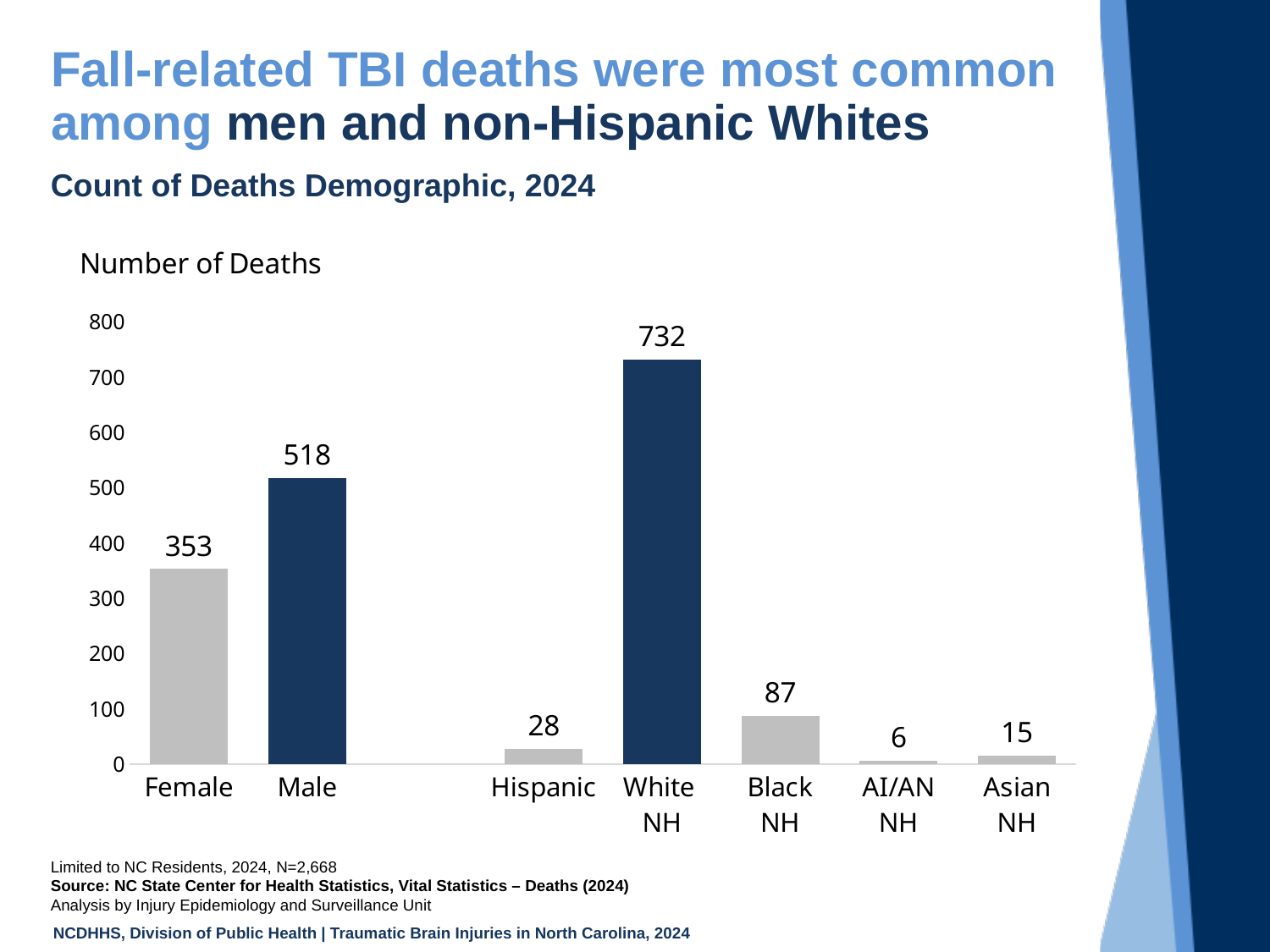
Which category has the highest number of deaths? White NH What is the number of deaths shown for Hispanic? 28 How many categories are shown on the x axis? 7 What is the number of deaths shown for AI/AN NH? 6 What is the difference in deaths between White NH and Black NH? 645 What is the number of deaths shown for White NH? 732 Which category has the lowest number of deaths? AI/AN NH What is the label of the y axis? Number of Deaths Which has more deaths, Black NH or Asian NH? Black NH What type of chart is shown on the slide? Bar chart What is the difference in deaths between Male and Female? 165 What is the number of fall-related TBI deaths for Male? 518